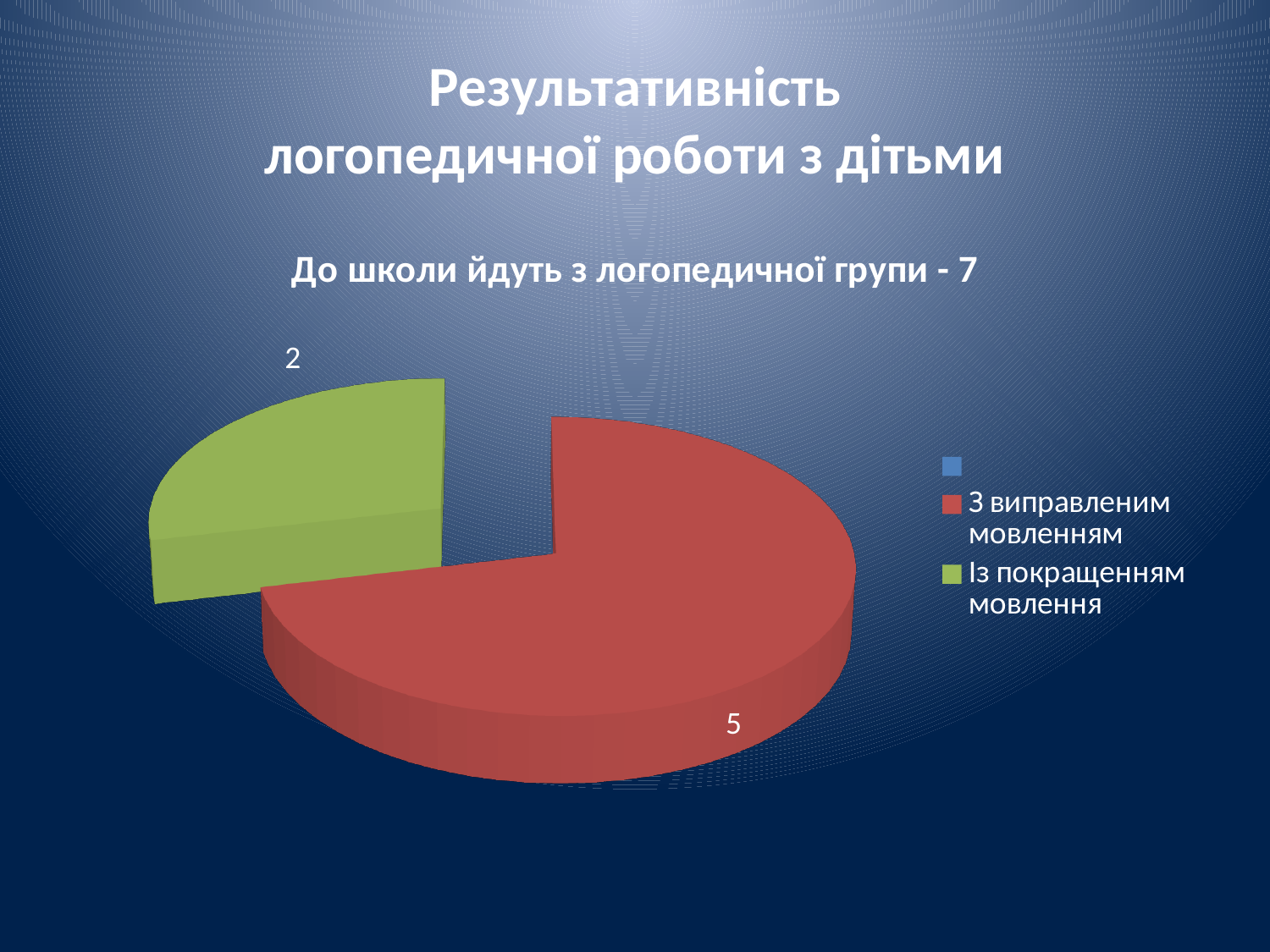
How many slices does the pie chart have? 2 Which is larger: the value for "З виправленим мовленням" or for "Із покращенням мовлення"? З виправленим мовленням What is the total of the two slices in the pie chart? 7 What is the title shown above the pie chart? До школи йдуть з логопедичної групи - 7 What is the value for the slice "З виправленим мовленням"? 5 Which category has the largest slice of the pie? З виправленим мовленням Which category has the smallest slice of the pie? Із покращенням мовлення What fraction of the pie does the slice "З виправленим мовленням" represent? 5/7 What is the value for the slice "Із покращенням мовлення"? 2 What type of chart is shown on the slide? Pie chart What colour is the slice for "Із покращенням мовлення"? Green What is the difference between the values for "З виправленим мовленням" and "Із покращенням мовлення"? 3